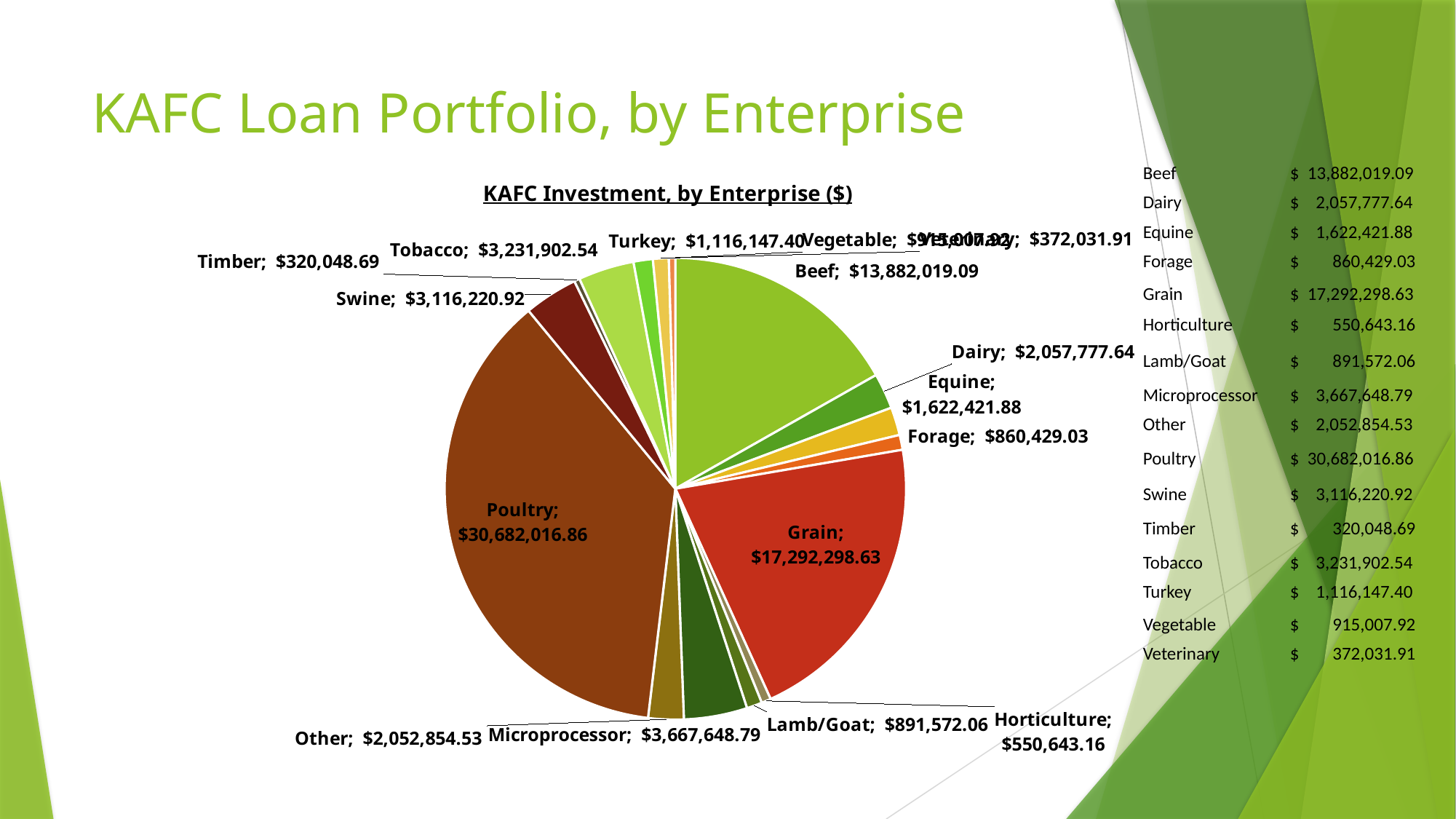
What is the value for Grain in the pie chart? $17,292,298.63 Which enterprise has the largest slice of the pie chart? Poultry Which enterprise has the smallest value in the pie chart? Timber What is the difference between the Grain and Beef values? $3,410,279.54 What is the title of the chart? KAFC Investment, by Enterprise ($) What is the difference between the Poultry and Grain values? $13,389,718.23 How many enterprise categories are shown in the pie chart? 16 What is the value for Poultry in the pie chart? $30,682,016.86 What type of chart is shown on the slide? Pie chart What is the value for Horticulture in the pie chart? $550,643.16 What is the value for Microprocessor in the pie chart? $3,667,648.79 Which is larger, the value for Tobacco or the value for Swine? Tobacco